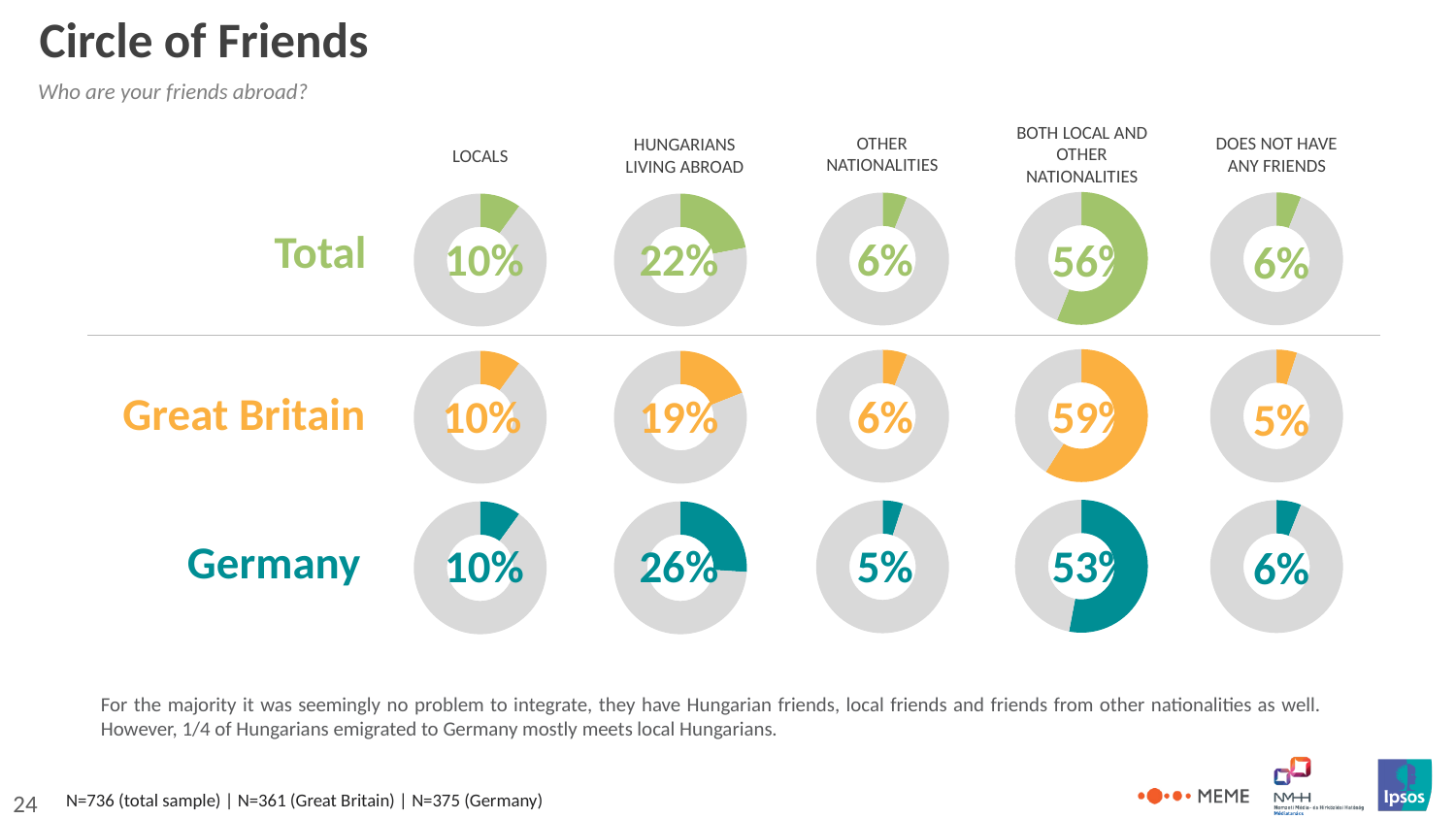
In the Total row, which category has the highest percentage? Both local and other nationalities In the Great Britain row, what percentage is shown for Does not have any friends? 5% In the Germany row, what percentage is shown for Hungarians living abroad? 26% How many donut charts are shown in the Total row? 5 In the Great Britain row, what percentage is shown for Both local and other nationalities? 59% For Both local and other nationalities, which is larger: the Great Britain value or the Germany value? Great Britain In the Germany row, what percentage is shown for Other nationalities? 5% In the Total row, what percentage is shown for Hungarians living abroad? 22% What is the difference between the Germany and Great Britain percentages for Hungarians living abroad? 7 percentage points In the Germany row, which category has the lowest percentage? Other nationalities What colour are the donut charts in the Germany row? Teal What kind of chart is used to show each percentage on this slide? Donut (pie) chart